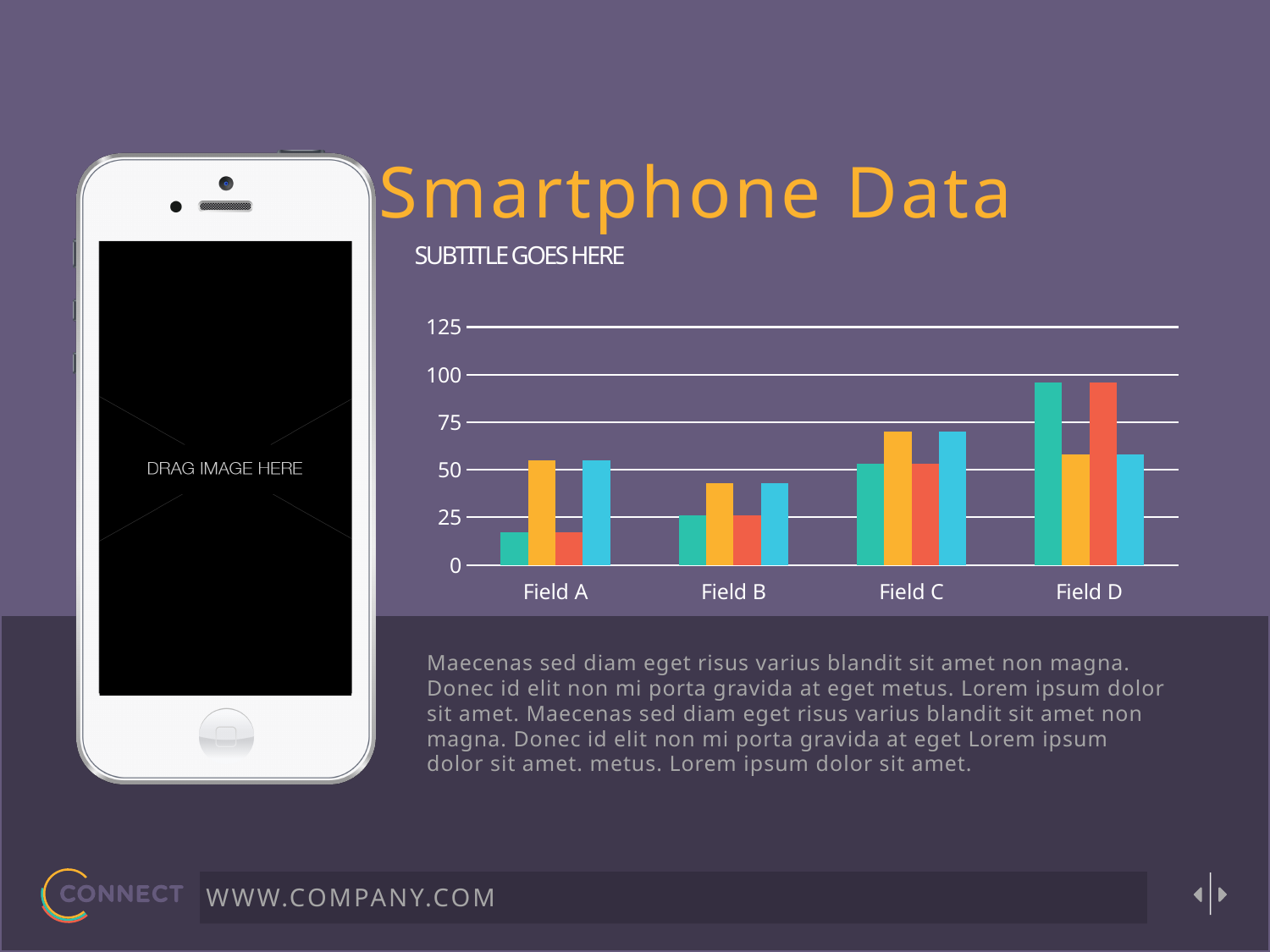
Which is larger: the yellow bar for Field A or the yellow bar for Field B? Field A Do the green bars rise or fall from Field A to Field D? rise Is the value of the green bar for Field A greater or less than 25? less Is the value of the blue bar for Field B greater or less than 50? less How many categories are shown on the x axis of the chart? 4 Is the value of the green bar for Field D greater or less than 75? greater What is the title of the slide containing the chart? Smartphone Data What kind of chart is shown on the slide? bar chart Which category has the shortest green bar? Field A Which category has the tallest green bar? Field D How many bars are plotted for each category in the chart? 4 What is the highest value shown on the chart's vertical axis? 125